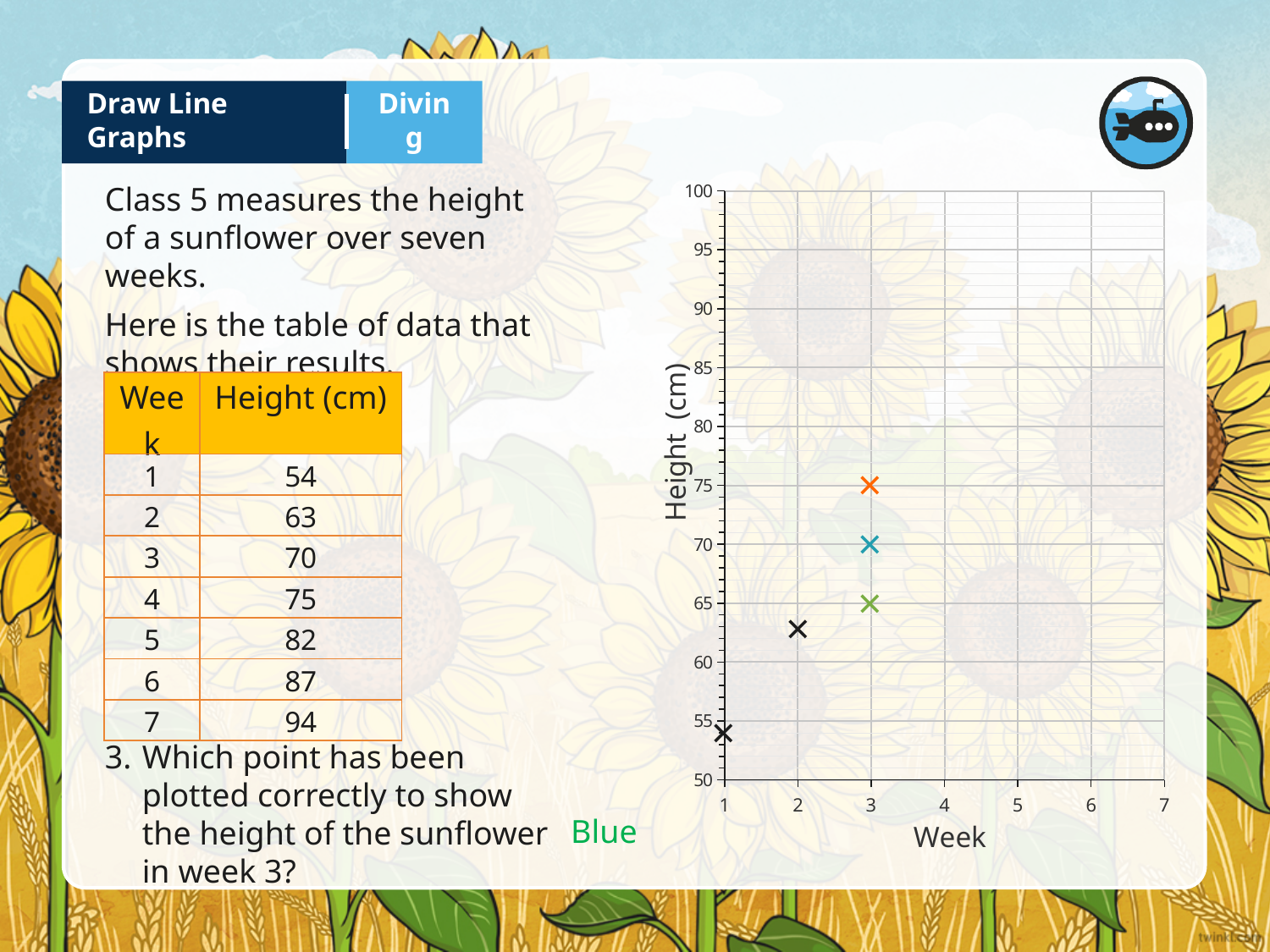
How many points are plotted at week 3 on the chart? 3 What is the label on the y axis of the chart? Height (cm) Is the point plotted at week 1 greater or less than 55? less What is the label on the x axis of the chart? Week What height does the green cross at week 3 show? 65 Is the point plotted at week 2 greater or less than 60? greater Does the plotted height rise or fall from week 1 to week 2? rise What height does the orange cross at week 3 show? 75 What is the difference in height between the orange cross and the green cross at week 3? 10 What height does the blue cross at week 3 show? 70 Which coloured cross at week 3 is plotted lowest on the chart? green Which coloured cross at week 3 is plotted highest on the chart? orange